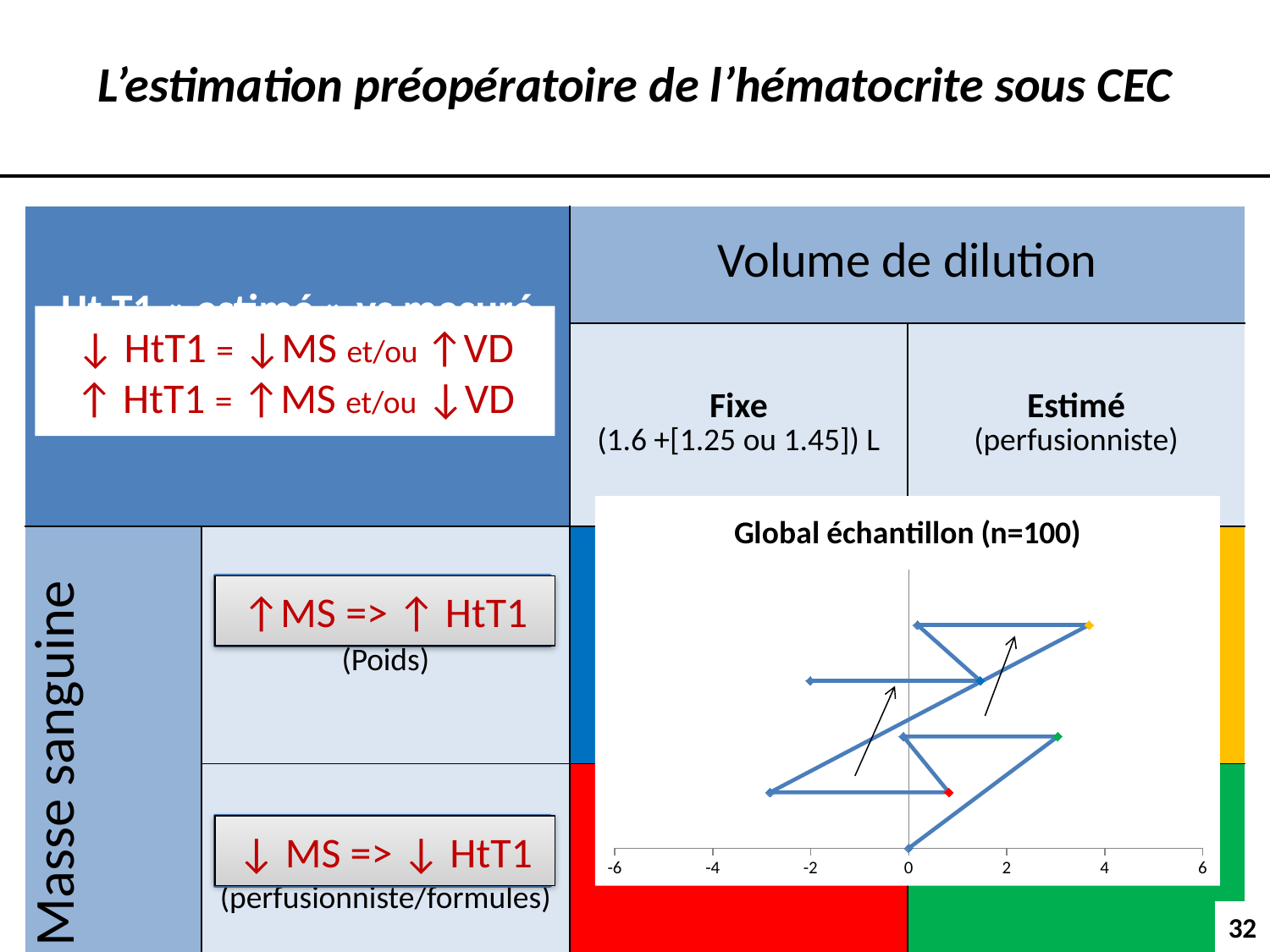
Is the x value of the red marker greater or less than 0? greater What is the title of the chart on the slide? Global échantillon (n=100) What sample size is stated in the chart title? n=100 What kind of chart is shown on the slide? scatter chart How many tick labels are shown on the chart's x axis? 7 What is the lowest value labelled on the chart's x axis? -6 Is the x value of the yellow marker greater or less than 2? greater Which marker lies further to the right on the x axis, the yellow one or the green one? the yellow one Is the x value of the leftmost marker greater or less than -2? less What is the highest value labelled on the chart's x axis? 6